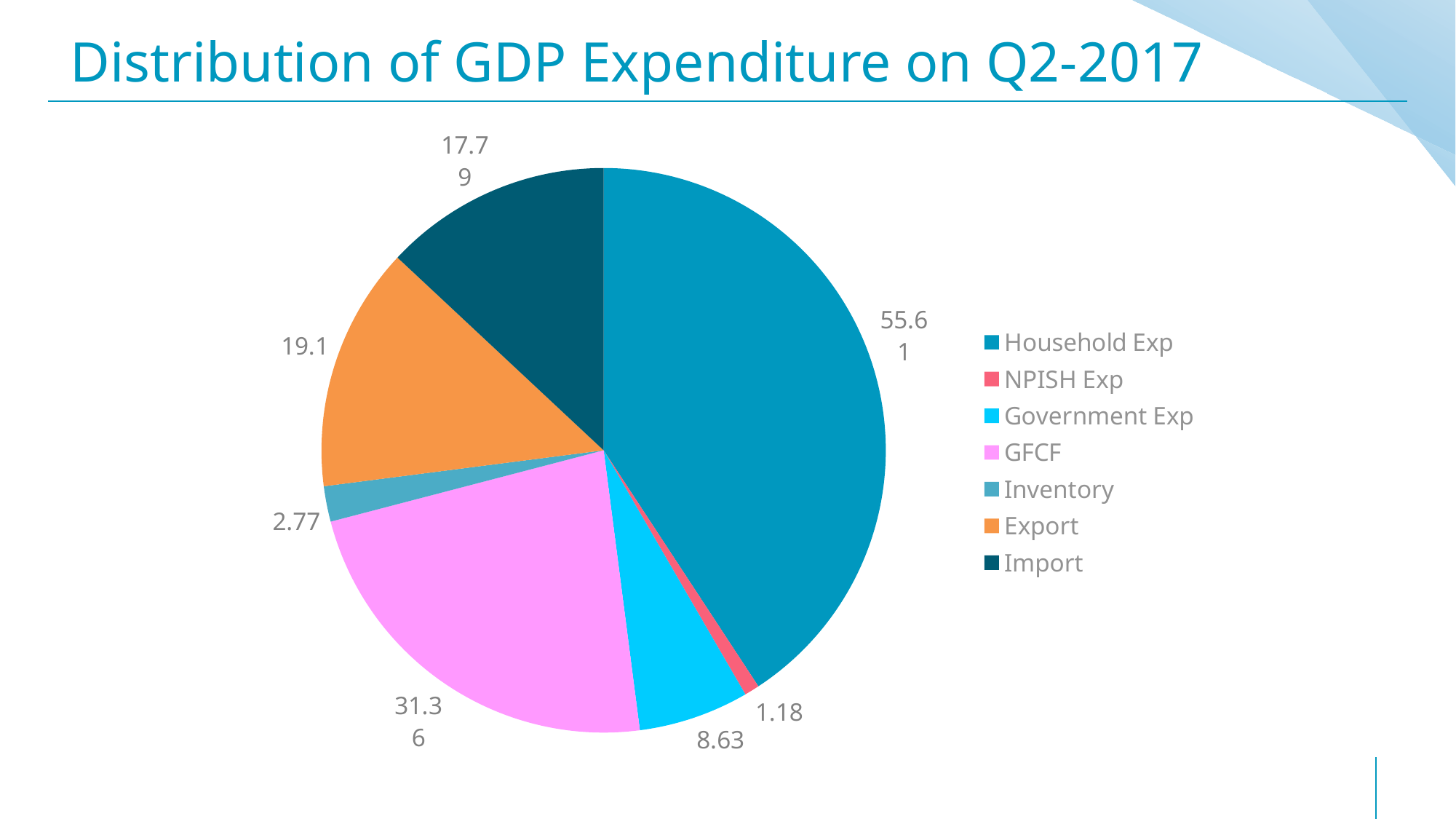
Which is larger, Export or Import? Export Which category has the smallest slice of the pie? NPISH Exp What is the difference between the values for Export and Import? 1.31 What is the value for Government Exp? 8.63 Which category has the largest slice of the pie? Household Exp What is the value for Export? 19.1 What is the value for Inventory? 2.77 What is the title of the chart? Distribution of GDP Expenditure on Q2-2017 What is the value for NPISH Exp? 1.18 What type of chart is shown on the slide? Pie chart What is the value for Household Exp? 55.61 How many categories does the legend list? 7